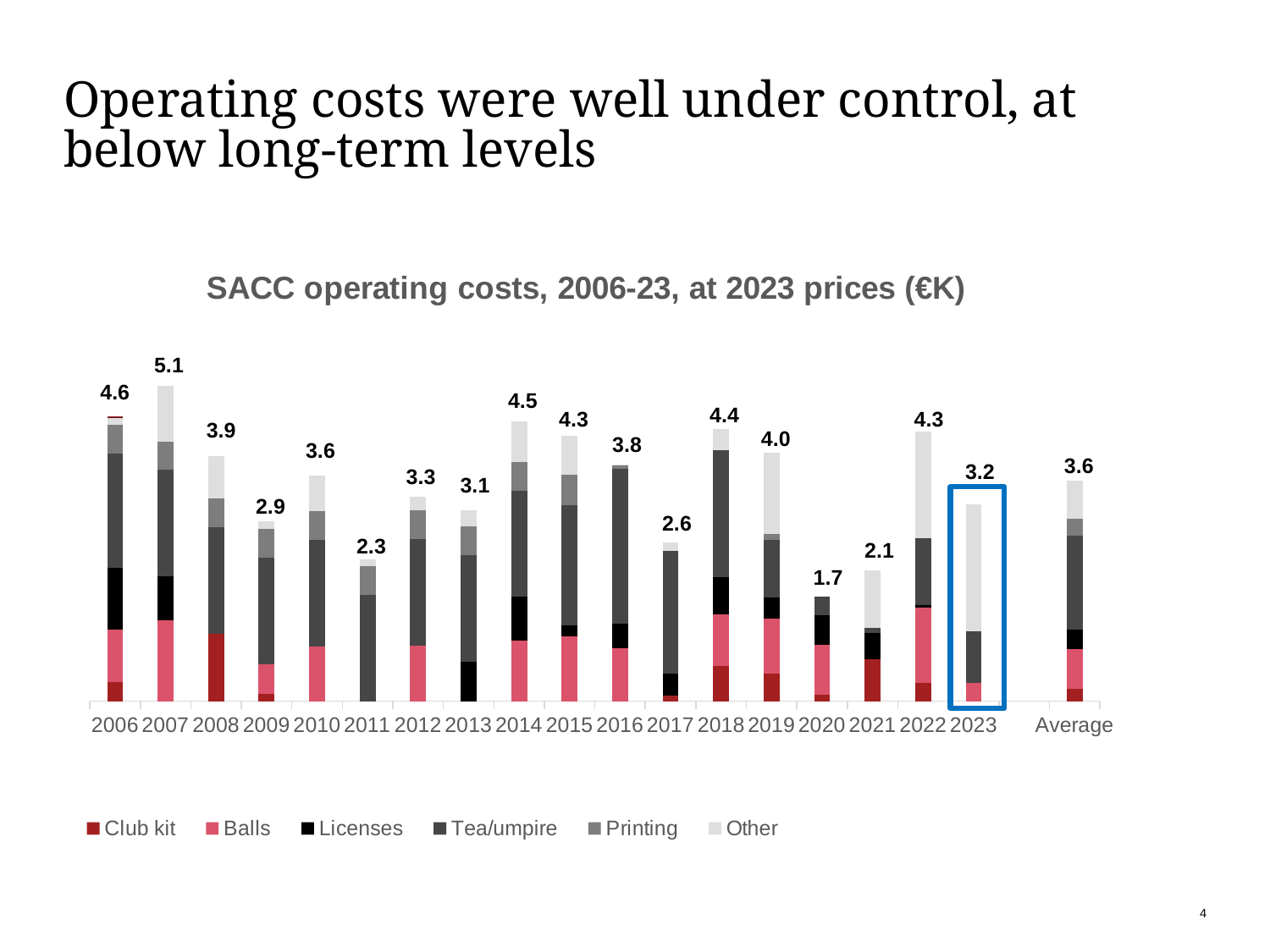
What is the difference between the Average total and the 2023 total? 0.4 What is the value shown for the Average bar? 3.6 What kind of chart is shown on the slide? Stacked bar chart What is the title of the chart? SACC operating costs, 2006-23, at 2023 prices (€K) Which is larger, the total for 2014 or the total for 2018? 2014 Which year has the highest total operating cost? 2007 How many bars are plotted on the chart, including the Average bar? 19 How many series does the legend list? 6 Which year has the lowest total operating cost? 2020 What is the total operating cost shown for 2023? 3.2 What is the total operating cost shown for 2007? 5.1 What is the difference between the total for 2007 and the total for 2020? 3.4